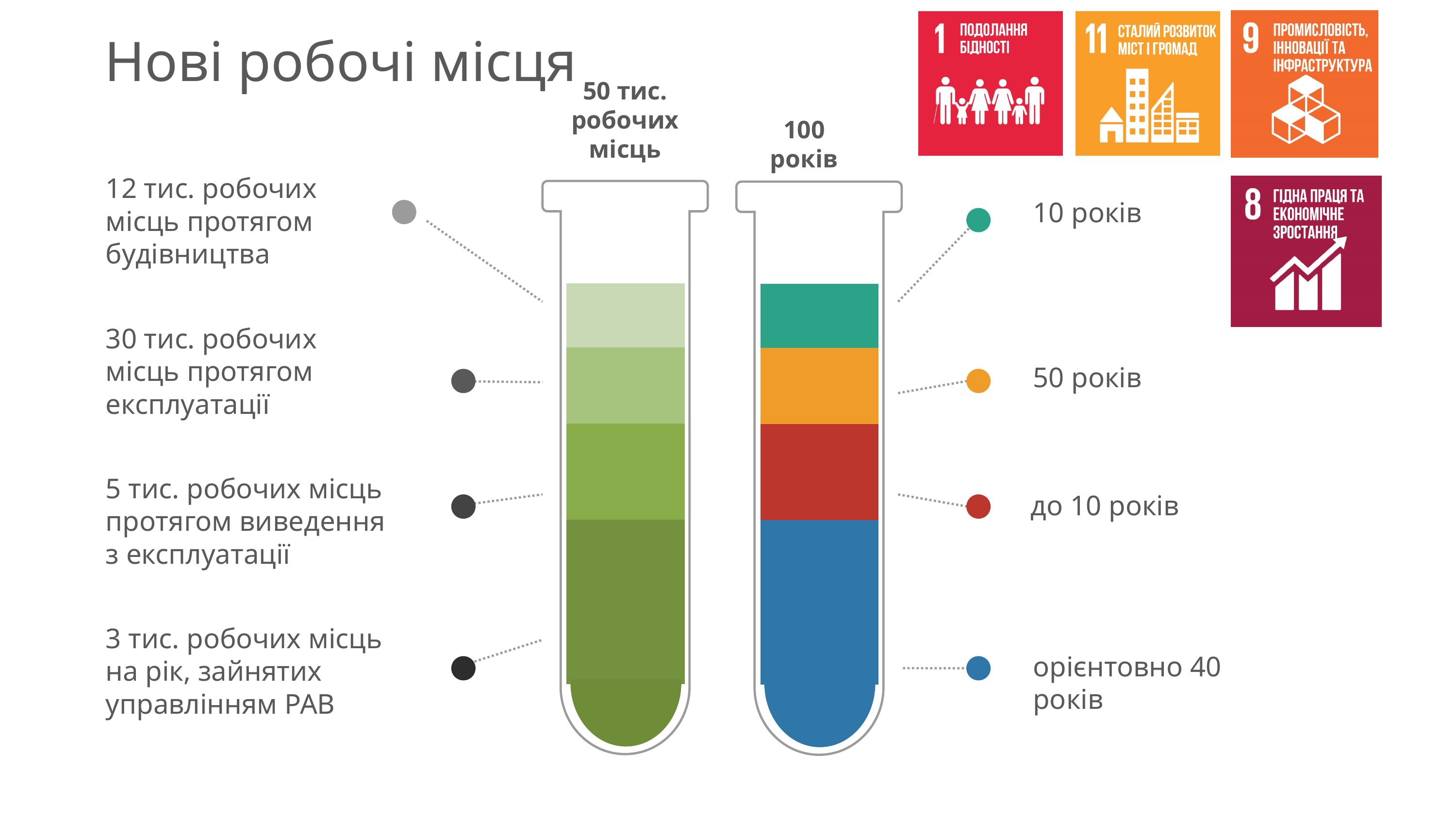
On the right test tube chart, what duration is labelled for the blue segment at the bottom? орієнтовно 40 років On the right test tube chart, what total duration is shown at the top of the tube? 100 років On the right test tube chart (100 років), what duration is labelled for the orange segment? 50 років On the left test tube chart, what is the total number of jobs shown at the top of the tube? 50 тис. робочих місць On the left test tube chart (50 тис. робочих місць), how many jobs are created during construction (протягом будівництва)? 12 тис. робочих місць On the left test tube chart, which phase accounts for the largest number of jobs? протягом експлуатації (30 тис.) On the left test tube chart, how many jobs per year are occupied with radioactive waste management (управлінням РАВ)? 3 тис. робочих місць на рік On the left test tube chart, how many jobs are created during decommissioning (протягом виведення з експлуатації)? 5 тис. робочих місць On the left test tube chart, which is larger: jobs during construction or jobs during decommissioning? jobs during construction (12 тис.) On the left test tube chart, how many jobs are created during operation (протягом експлуатації)? 30 тис. робочих місць On the left test tube chart, what is the difference between the jobs during operation and the jobs during construction? 18 тис. How many segments does the left test tube chart contain? 4